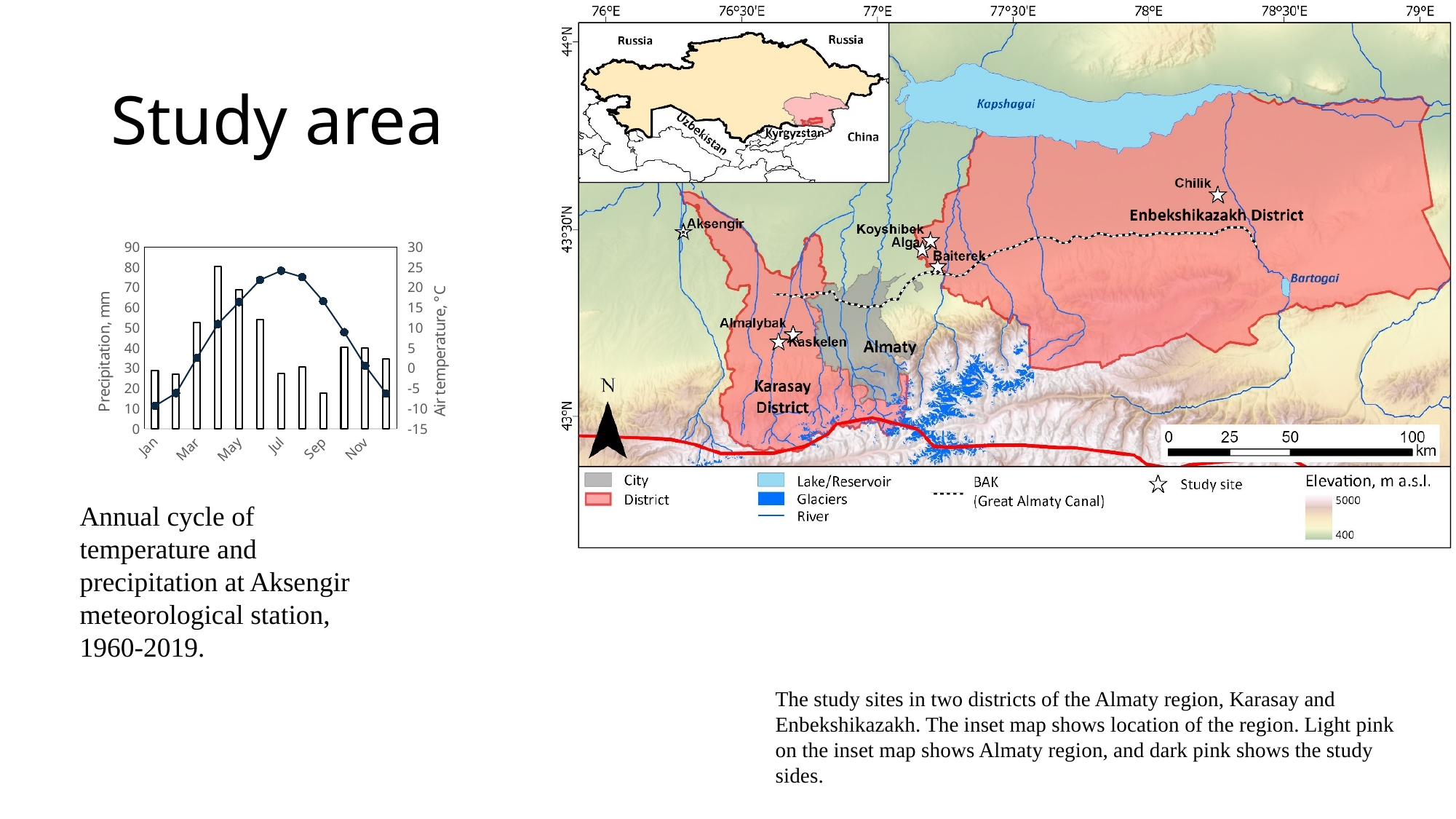
Does air temperature rise or fall from Jan to Jul in the Aksengir chart? rise Is the precipitation value for Sep greater or less than 30 mm? less In which month is air temperature highest in the Aksengir chart? Jul What is the label of the right-hand vertical axis of the Aksengir chart? Air temperature, °C Is the air temperature for Jan greater or less than 0 °C? less In which month is air temperature lowest in the Aksengir chart? Jan In which month is precipitation lowest in the Aksengir chart? Sep How many monthly bars are plotted in the precipitation chart? 12 Is the air temperature for Jul greater or less than 20 °C? greater What kind of chart is used to show the annual cycle of temperature and precipitation at Aksengir? A combined bar and line chart In which month is precipitation highest in the Aksengir chart? Apr